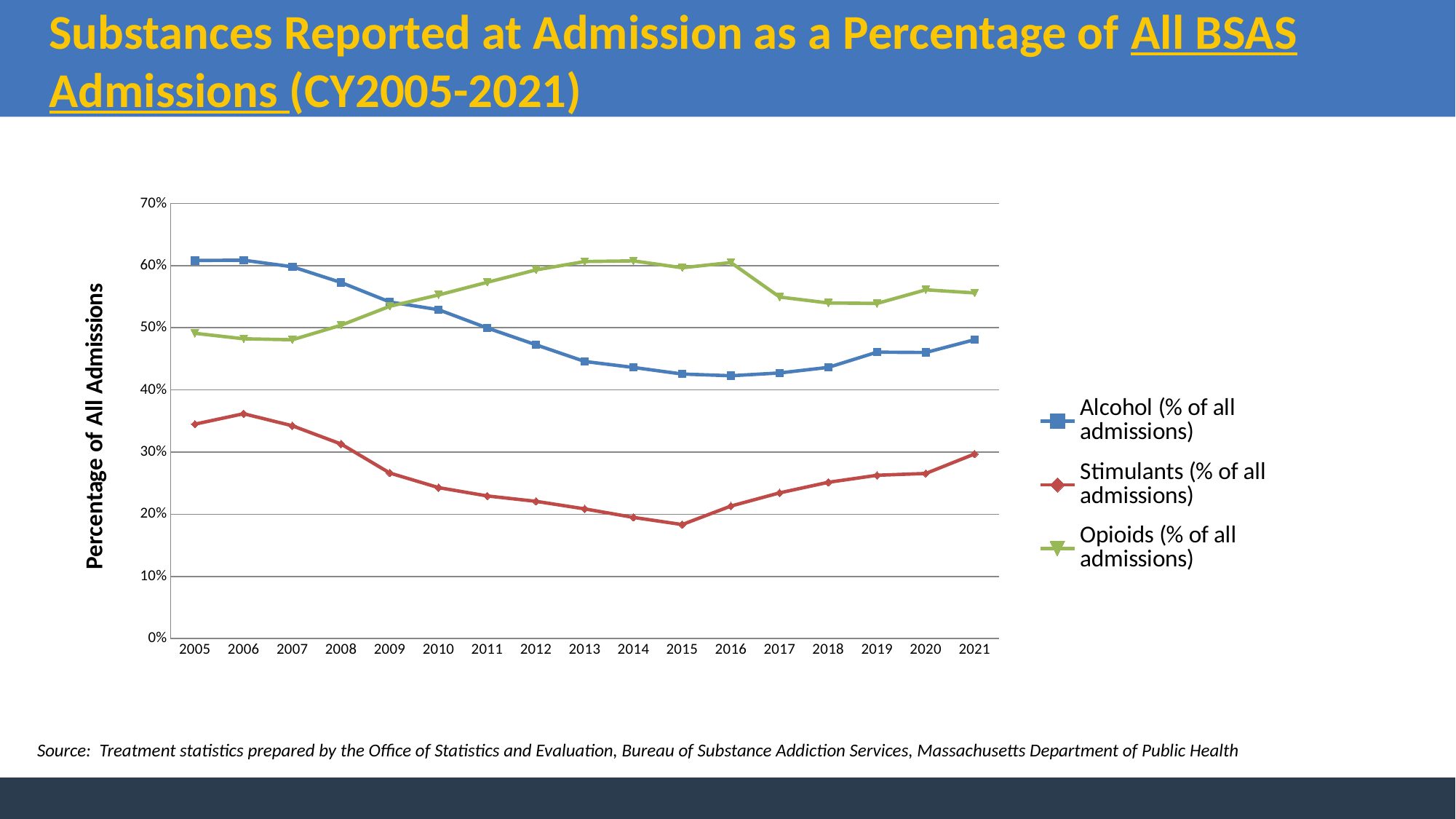
What is the title of the y axis? Percentage of All Admissions How many years are plotted along the x axis? 17 Is the value for Stimulants in 2015 greater or less than 20%? less How many series does the legend list? 3 What kind of chart is shown on the slide? Line chart In which year is the Stimulants series at its lowest? 2015 Does the Alcohol series rise or fall from 2005 to 2015? Fall In 2021, which is larger: Alcohol or Opioids? Opioids Is the value for Alcohol in 2005 greater or less than 60%? greater In which year is the Stimulants series at its highest? 2006 Is the value for Alcohol in 2021 greater or less than 50%? less